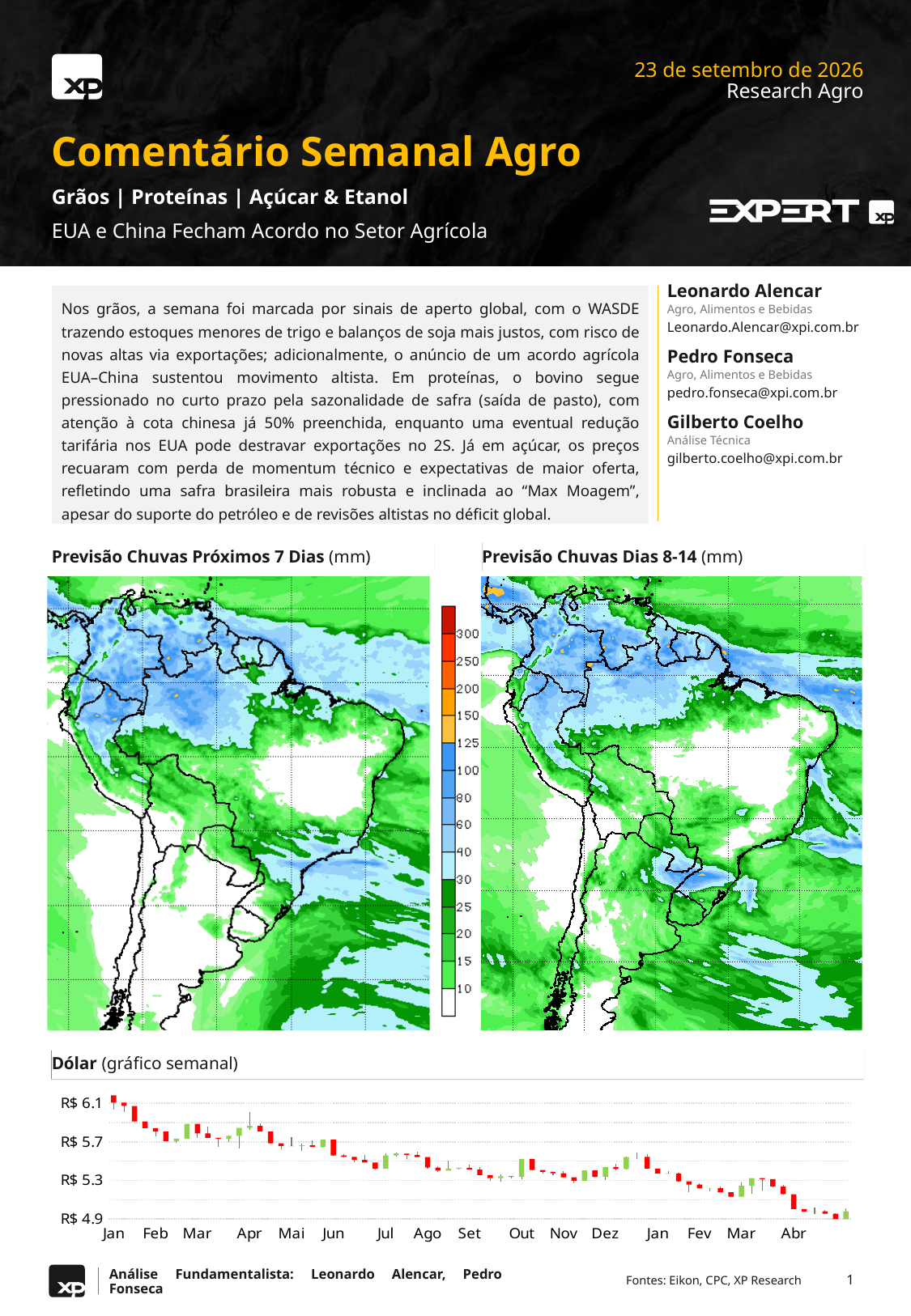
In the 'Dólar (gráfico semanal)' chart, which is higher: the value in the first Jan or the value in Abr? First Jan In the 'Dólar (gráfico semanal)' chart, do the values generally rise or fall from left to right along the x axis? Fall In the 'Dólar (gráfico semanal)' chart, is the value around Jul greater or less than R$ 5.7? less In the 'Dólar (gráfico semanal)' chart, is the value at the end of the series (Abr) greater or less than R$ 5.3? less What is the highest value labelled on the y axis of the 'Dólar (gráfico semanal)' chart? R$ 6.1 What is the lowest value shown on the colour scale of the rainfall forecast maps? 10 What is the title of the left-hand rainfall map on the slide? Previsão Chuvas Próximos 7 Dias (mm) What is the highest value shown on the colour scale of the rainfall forecast maps? 300 How many month labels are shown on the x axis of the 'Dólar (gráfico semanal)' chart? 16 In the 'Dólar (gráfico semanal)' chart, is the value at the start of the series (first Jan) greater or less than R$ 5.7? greater What is the lowest value labelled on the y axis of the 'Dólar (gráfico semanal)' chart? R$ 4.9 What kind of chart is the 'Dólar (gráfico semanal)' chart at the bottom of the slide? Candlestick chart